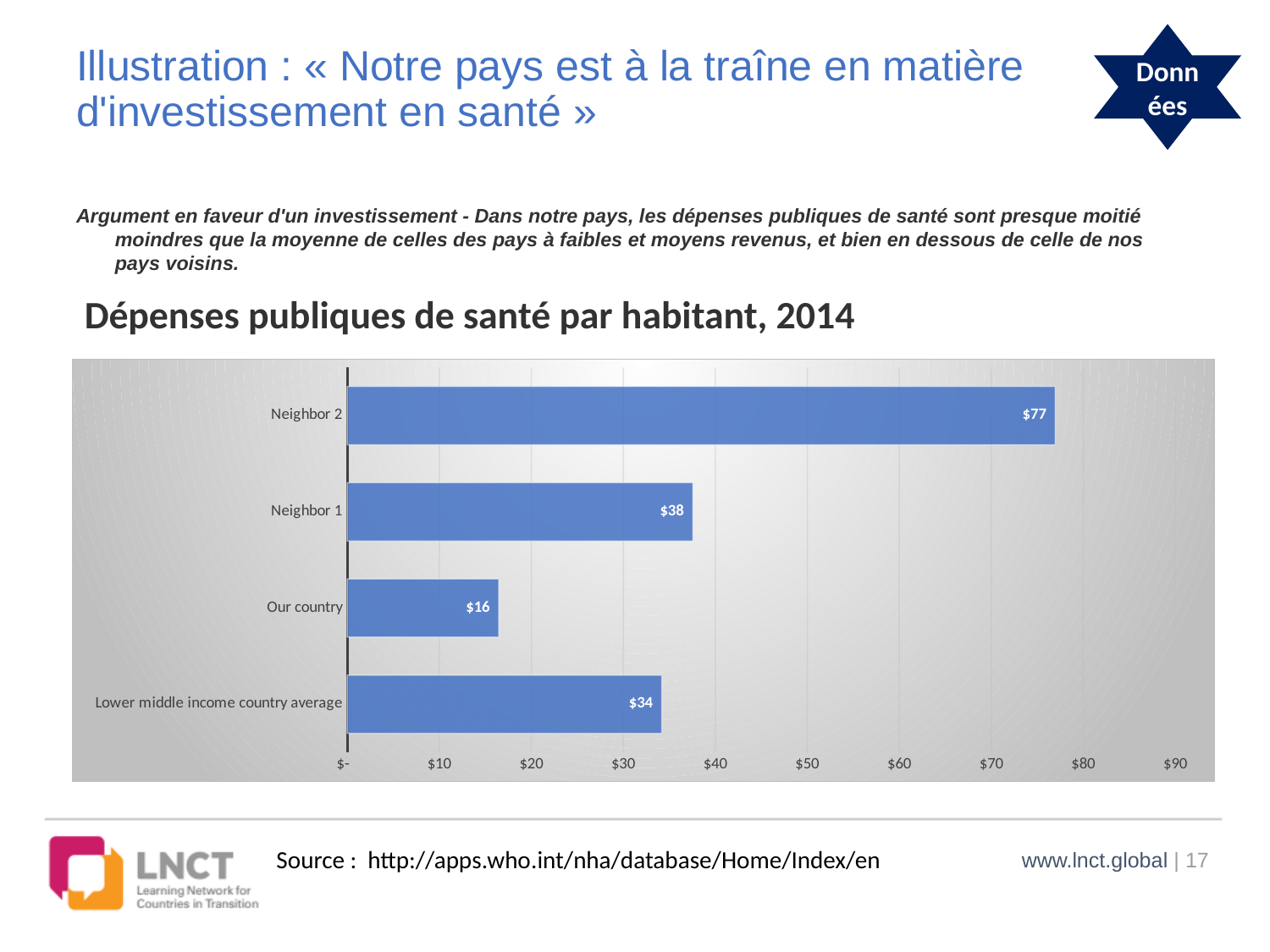
What is the value for Neighbor 1? $38 What kind of chart is shown on the slide? Bar chart What is the difference between the values for Neighbor 1 and Lower middle income country average? $4 What is the value for Our country? $16 How many categories are shown in the chart? 4 What is the difference between the values for Neighbor 2 and Our country? $61 Which category has the lowest value? Our country Which category has the highest value? Neighbor 2 Which is larger, the value for Neighbor 1 or the value for Lower middle income country average? Neighbor 1 What is the value for Neighbor 2? $77 What is the value for Lower middle income country average? $34 What is the title of the chart? Dépenses publiques de santé par habitant, 2014